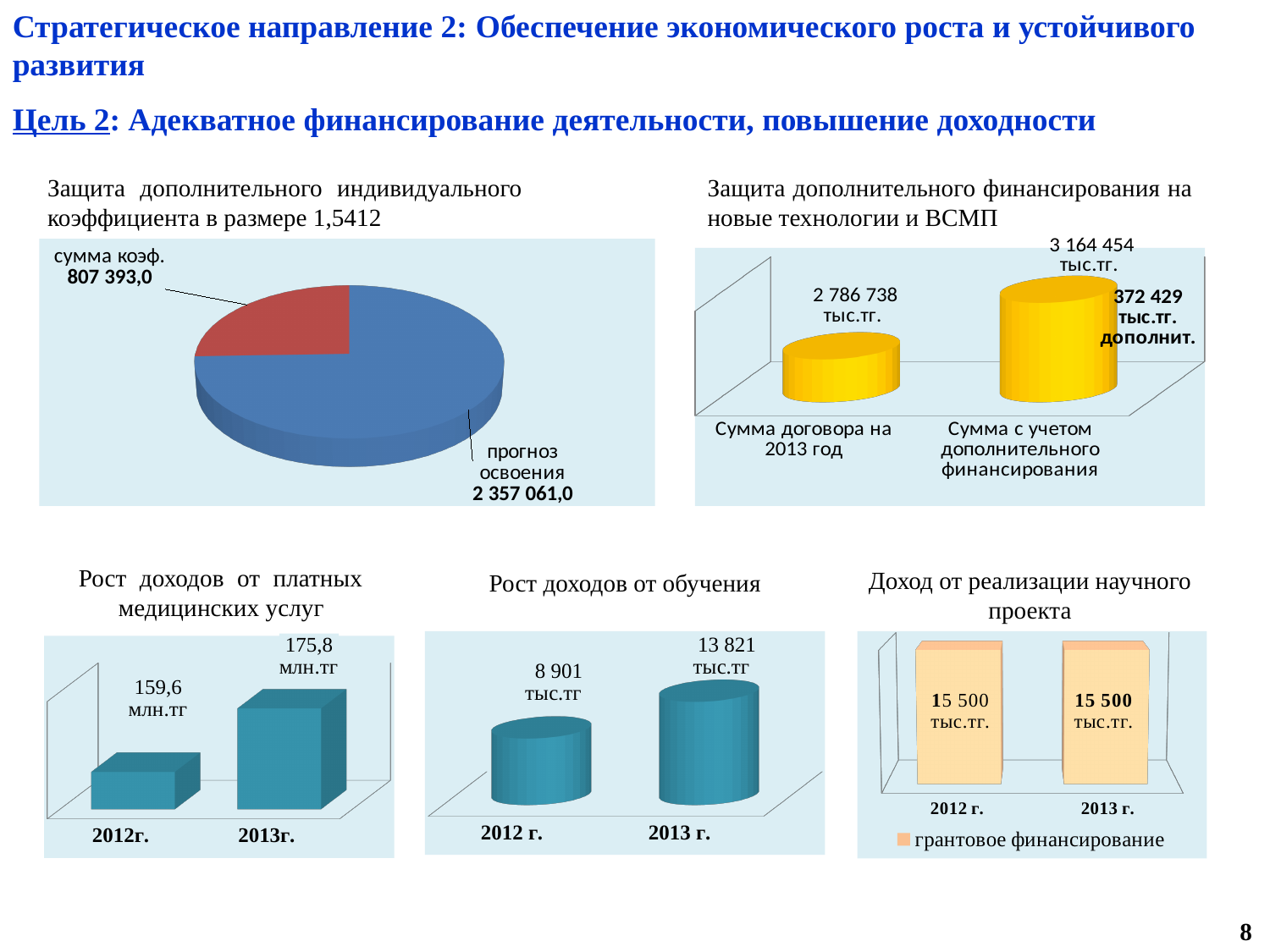
In the chart 'Защита дополнительного финансирования на новые технологии и ВСМП', what is the value for 'Сумма договора на 2013 год'? 2 786 738 тыс.тг. In the chart 'Рост доходов от обучения', what is the difference between the 2013 г. and 2012 г. values? 4 920 тыс.тг In the chart 'Рост доходов от платных медицинских услуг', what is the difference between the 2013г. and 2012г. values? 16,2 млн.тг In the chart 'Защита дополнительного финансирования на новые технологии и ВСМП', what is the value for 'Сумма с учетом дополнительного финансирования'? 3 164 454 тыс.тг. In the pie chart 'Защита дополнительного индивидуального коэффициента', which slice is larger: 'сумма коэф.' or 'прогноз освоения'? прогноз освоения In the chart 'Рост доходов от обучения', what is the value for 2012 г.? 8 901 тыс.тг In the chart 'Доход от реализации научного проекта', what is the value for 2013 г.? 15 500 тыс.тг. In the chart 'Доход от реализации научного проекта', what series name does the legend show? грантовое финансирование In the pie chart 'Защита дополнительного индивидуального коэффициента', what value is shown for 'прогноз освоения'? 2 357 061,0 In the chart 'Защита дополнительного финансирования на новые технологии и ВСМП', what additional amount ('дополнит.') is labelled on the chart? 372 429 тыс.тг. In the pie chart 'Защита дополнительного индивидуального коэффициента', what value is shown for 'сумма коэф.'? 807 393,0 In the chart 'Рост доходов от платных медицинских услуг', what is the value for 2013г.? 175,8 млн.тг